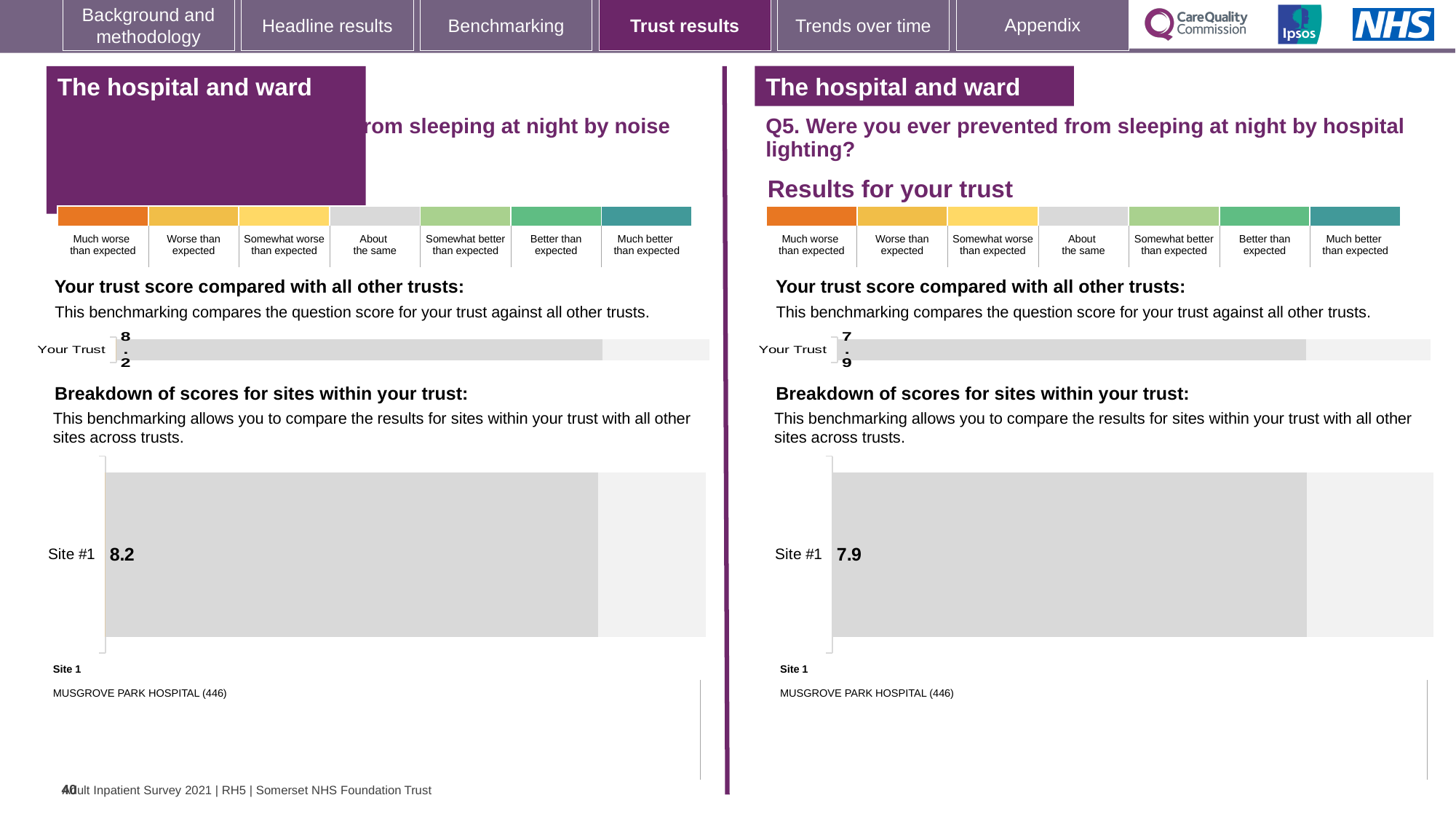
How many sites are shown in the right-hand 'Breakdown of scores for sites within your trust' chart (Q5, hospital lighting)? 1 What is the difference between the Site #1 score on the left-hand side (noise) and the Site #1 score on the right-hand side (Q5, hospital lighting)? 0.3 On the right-hand side of the slide (Q5, hospital lighting), what is the score shown for Your Trust? 7.9 What kind of chart is used to show the Site #1 score on the left-hand side of the slide? Bar chart Which hospital is listed as Site 1 on the right-hand side of the slide (Q5, hospital lighting)? MUSGROVE PARK HOSPITAL (446) How many categories does the colour key above the right-hand chart (Q5, hospital lighting) show, from 'Much worse than expected' to 'Much better than expected'? 7 In the right-hand 'Breakdown of scores for sites within your trust' chart (Q5, hospital lighting), what is the score for Site #1? 7.9 In the left-hand 'Breakdown of scores for sites within your trust' chart (sleeping at night by noise), what is the score for Site #1? 8.2 Which is larger: the Your Trust score on the left-hand side (noise) or the Your Trust score on the right-hand side (Q5, hospital lighting)? Left-hand side (noise), 8.2 On the left-hand side of the slide (sleeping at night by noise), what is the score shown for Your Trust? 8.2